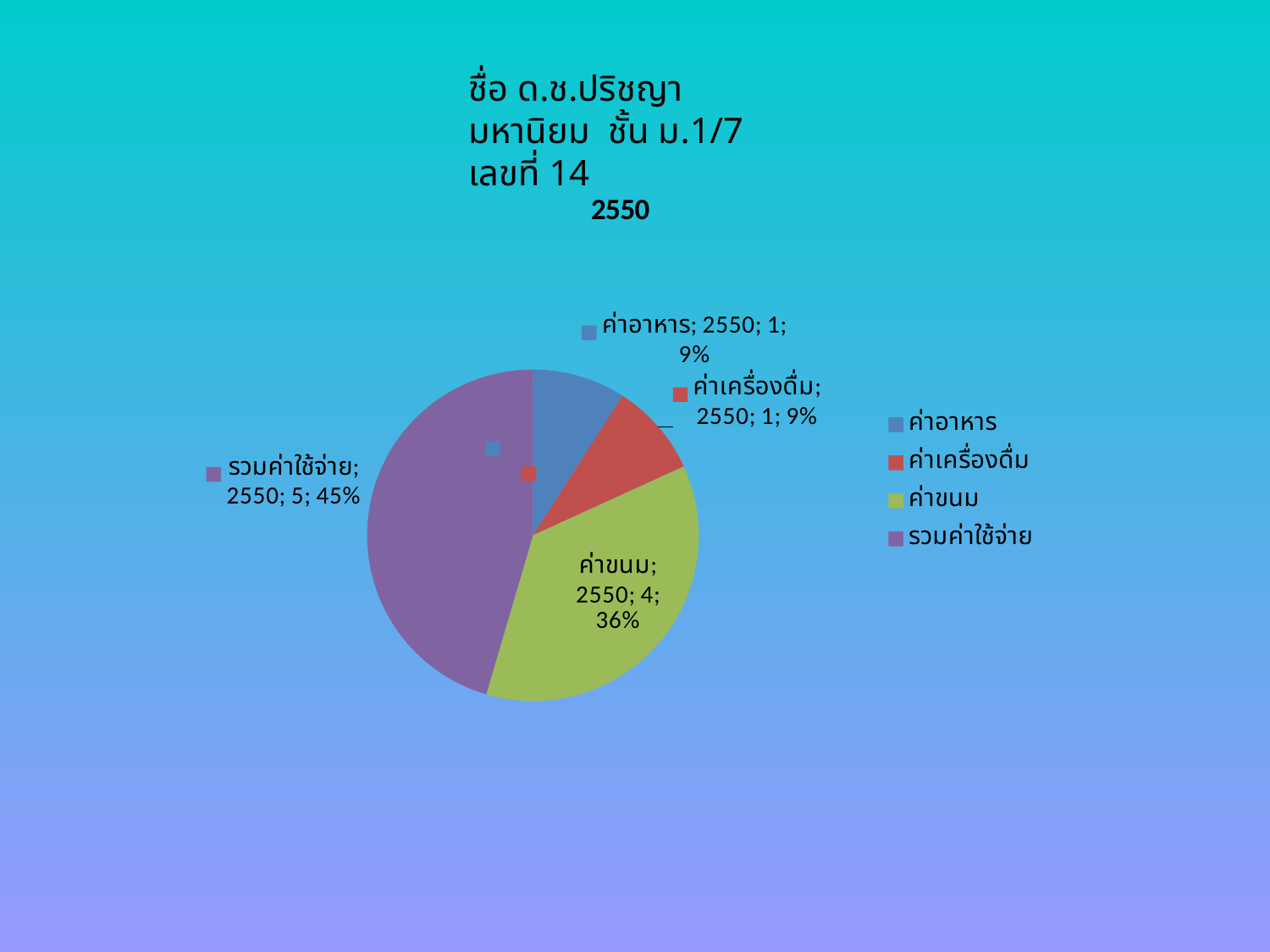
Which is larger, the slice for ค่าขนม or the slice for ค่าอาหาร? ค่าขนม What share of the pie does ค่าขนม represent? 36% What value is shown for ค่าขนม? 4 How many entries does the legend list? 4 What is the title of the chart? 2550 What value is shown for ค่าเครื่องดื่ม? 1 What value is shown for รวมค่าใช้จ่าย? 5 How many slices does the pie chart have? 4 What is the difference in percentage share between รวมค่าใช้จ่าย and ค่าขนม? 9% What kind of chart is shown on the slide? pie chart Which category has the largest slice of the pie? รวมค่าใช้จ่าย What share of the pie does ค่าอาหาร represent? 9%